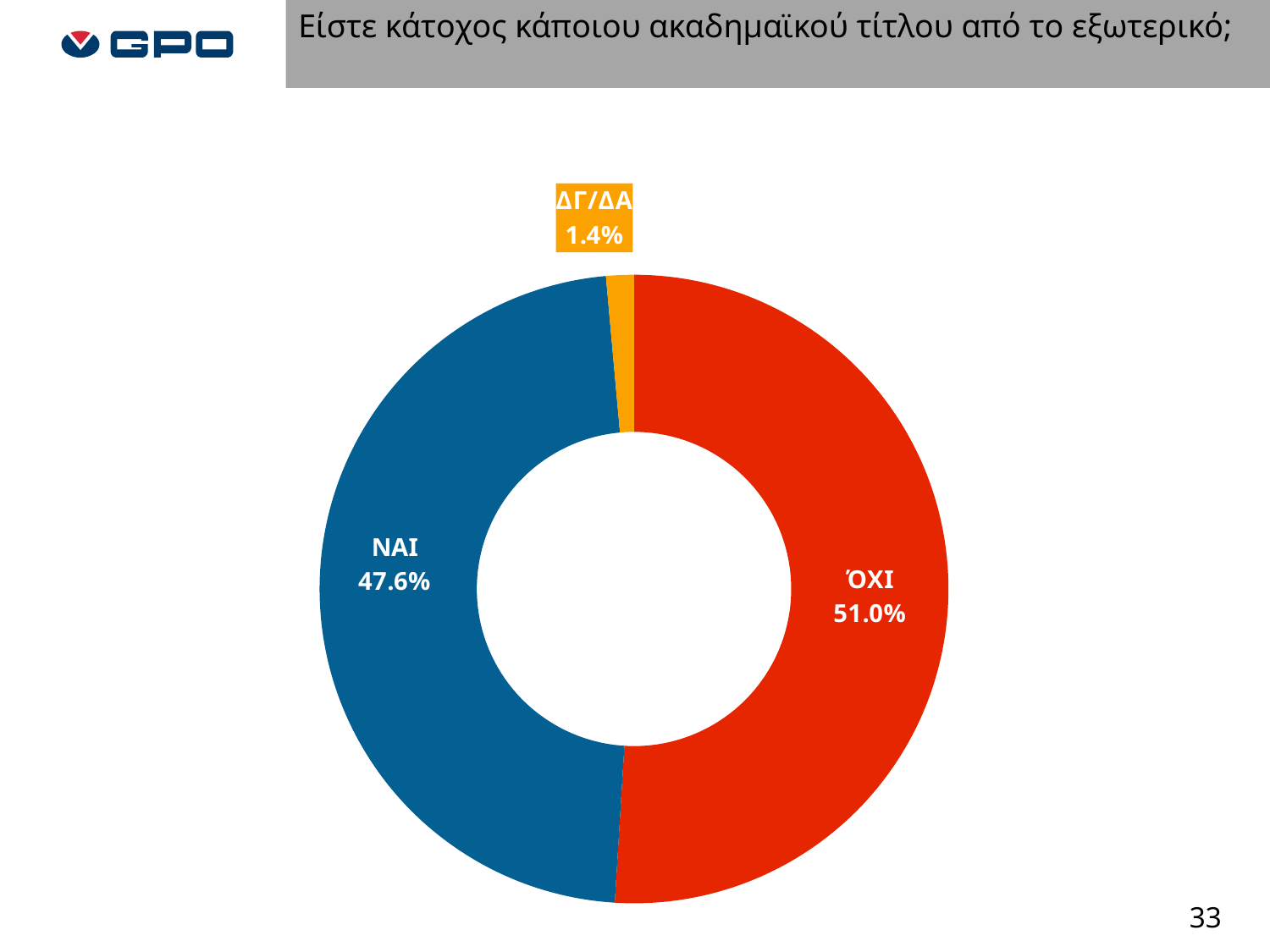
Which category has the largest share of the chart? ΌΧΙ What is the value shown for ΔΓ/ΔΑ? 1.4% What colour is the ΝΑΙ segment of the chart? Blue What is the difference in percentage points between ΌΧΙ and ΝΑΙ? 3.4 What question is shown as the title of the slide? Είστε κάτοχος κάποιου ακαδημαϊκού τίτλου από το εξωτερικό; How many categories are shown in the chart? 3 What is the combined share of ΝΑΙ and ΌΧΙ? 98.6% Which category has the smallest share of the chart? ΔΓ/ΔΑ What percentage of respondents answered ΌΧΙ? 51.0% What percentage of respondents answered ΝΑΙ? 47.6% What kind of chart is shown on the slide? Doughnut (pie) chart Which is larger, the share for ΝΑΙ or the share for ΌΧΙ? ΌΧΙ